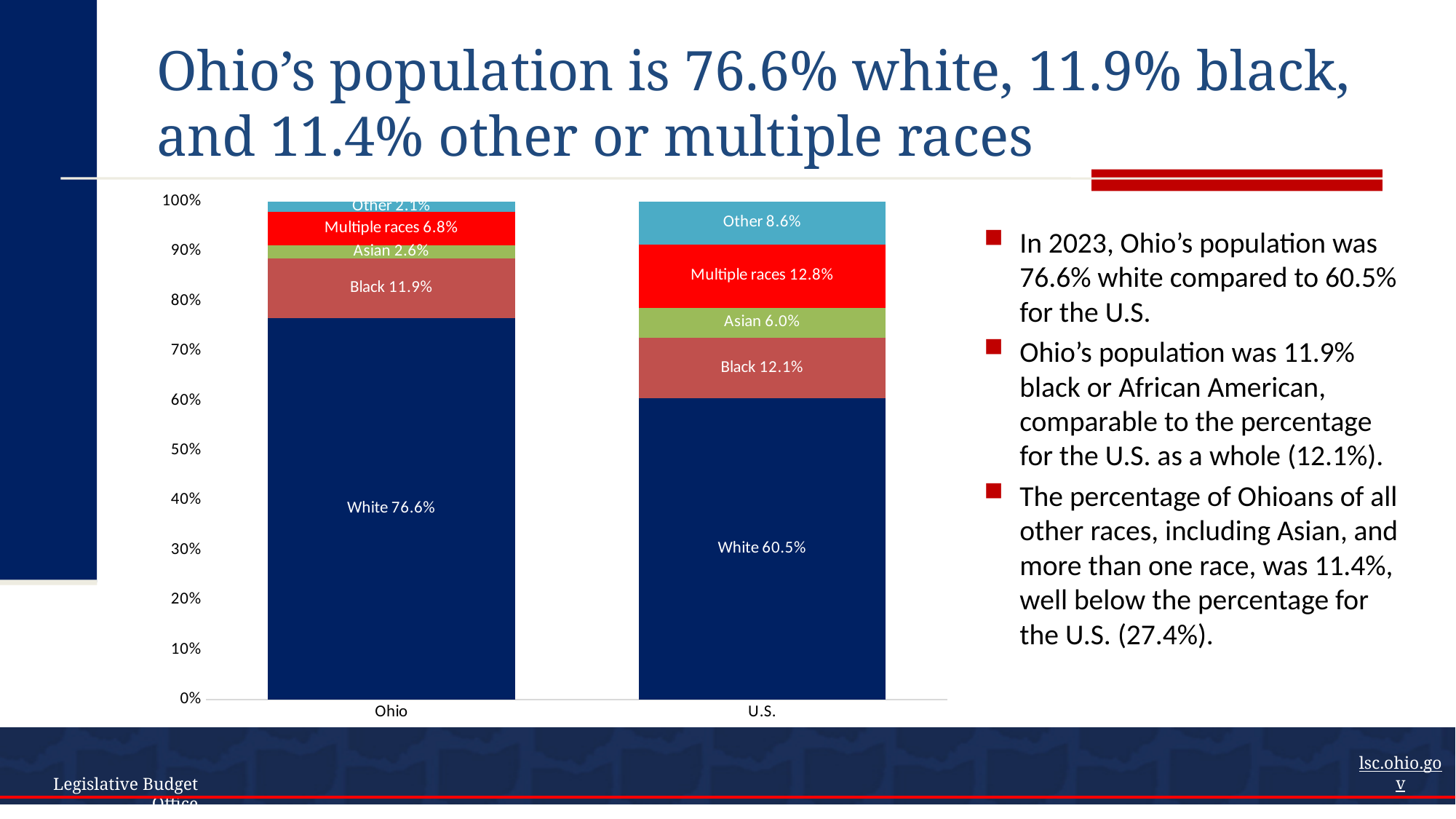
What is the value for Asian in the Ohio bar? 2.6% What is the value for Other in the Ohio bar? 2.1% Which segment is the smallest in the Ohio bar? Other What is the value for Black in the U.S. bar? 12.1% What is the combined share of Asian, Multiple races and Other in the Ohio bar? 11.5% What is the value for Multiple races in the U.S. bar? 12.8% What is the difference between the White share for Ohio and the White share for the U.S.? 16.1% Which is larger, the Asian share for Ohio or the Asian share for the U.S.? U.S. What kind of chart is shown on the slide? Stacked bar chart Which segment is the largest in the U.S. bar? White How many bars (categories) are shown on the x axis? 2 What percentage of Ohio's population is white according to the chart? 76.6%